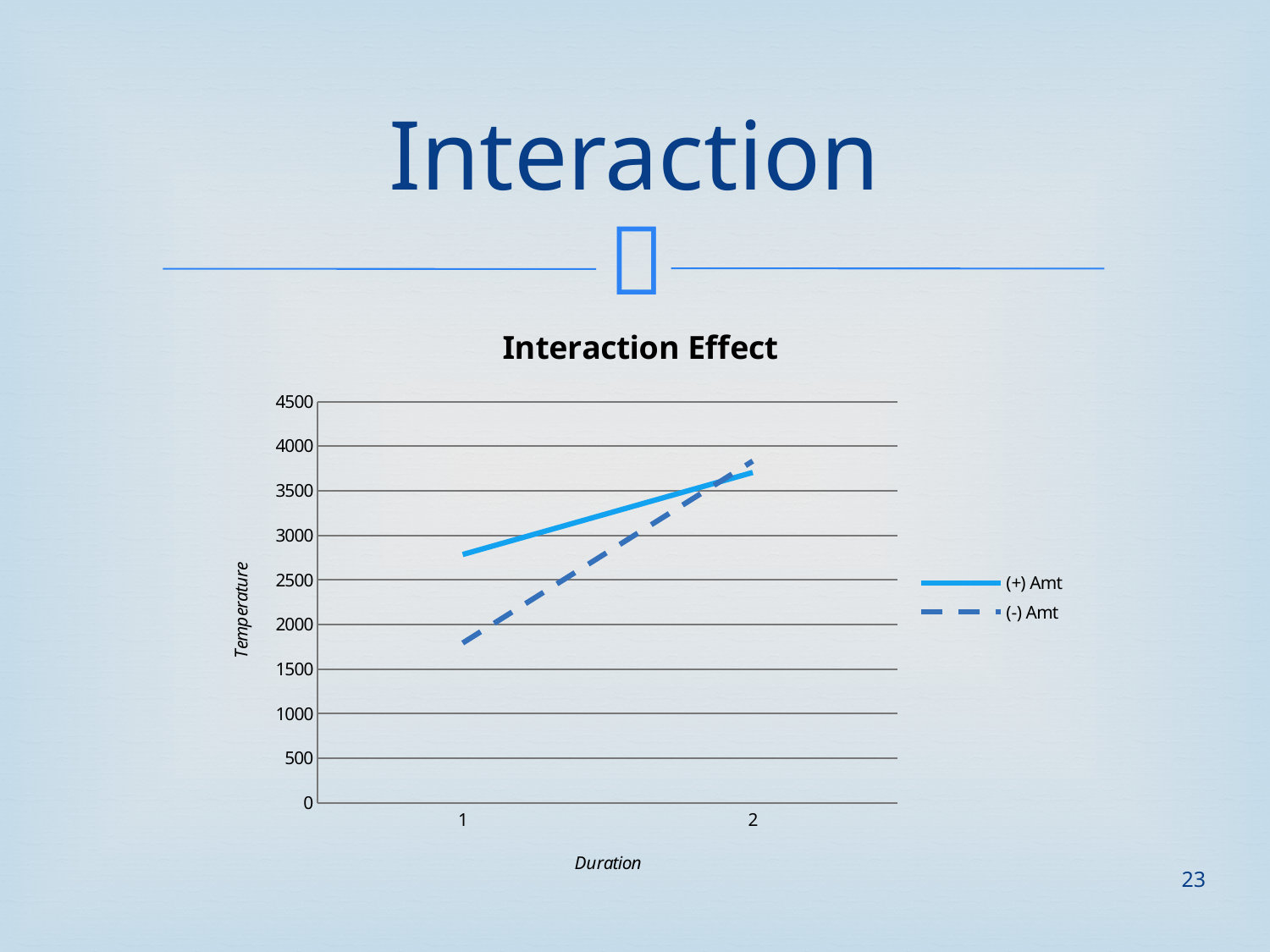
At Duration 1, which series has the larger value, (+) Amt or (-) Amt? (+) Amt How many Duration values are plotted on the x axis? 2 Is the value for (+) Amt at Duration 2 greater or less than 3500? greater Is the value for (+) Amt at Duration 1 greater or less than 3000? less Does the (-) Amt series rise or fall from Duration 1 to Duration 2? rise Is the value for (-) Amt at Duration 2 greater or less than 3500? greater How many series does the legend list? 2 What kind of chart is shown on the slide? line chart What is the title of the chart? Interaction Effect Which series is drawn with a dashed line? (-) Amt